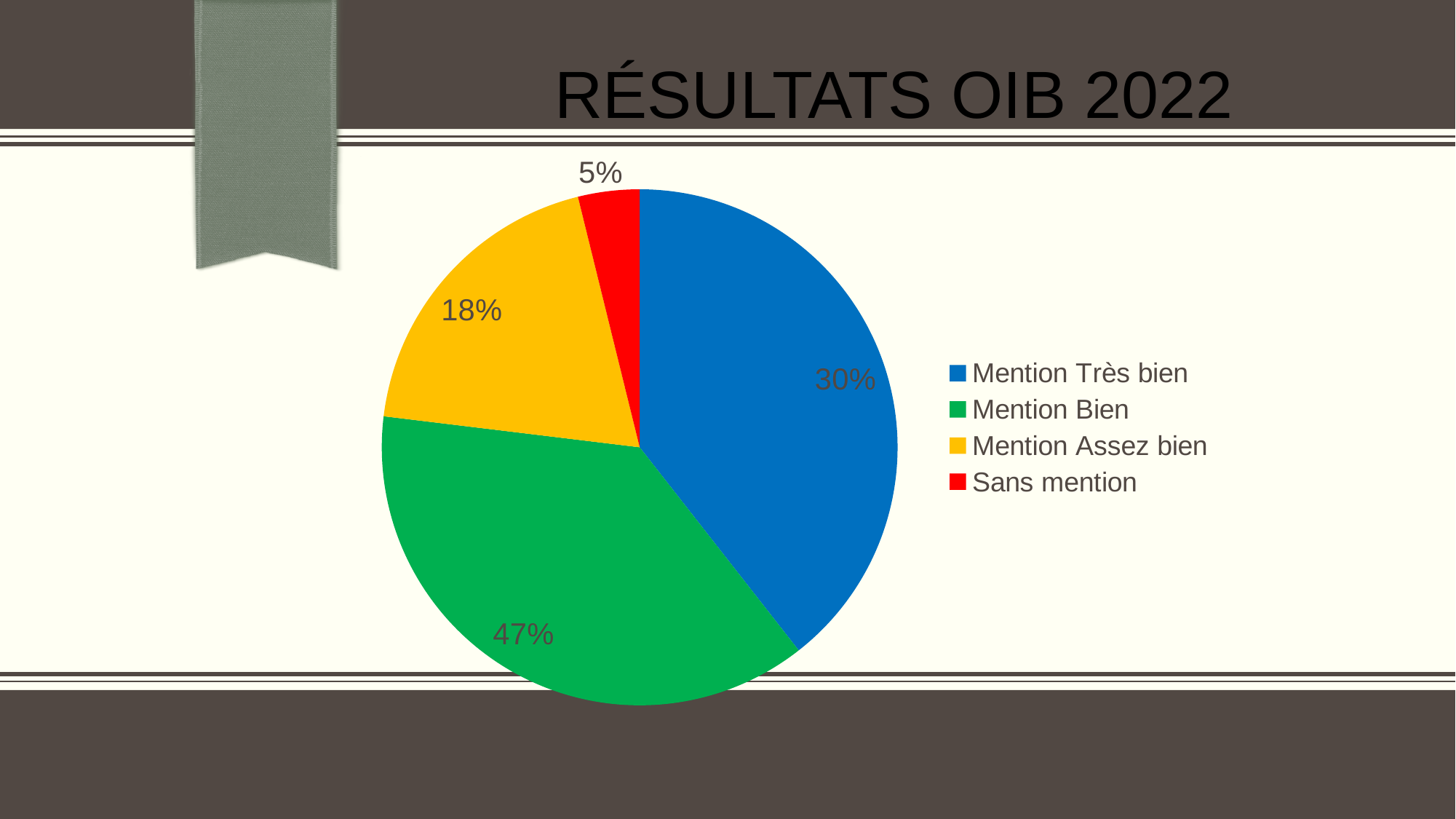
What is the title of the slide containing the chart? RÉSULTATS OIB 2022 What share of the pie does Mention Bien have? 47% What share of the pie does Mention Très bien have? 30% What share of the pie does Mention Assez bien have? 18% Which is larger, the slice for Mention Assez bien or the slice for Sans mention? Mention Assez bien What kind of chart is shown on the slide? pie chart What is the difference in percentage points between Mention Bien and Mention Très bien? 17 Which category has the smallest slice of the pie? Sans mention How many categories does the pie chart show? 4 What colour is the slice for Mention Assez bien? yellow